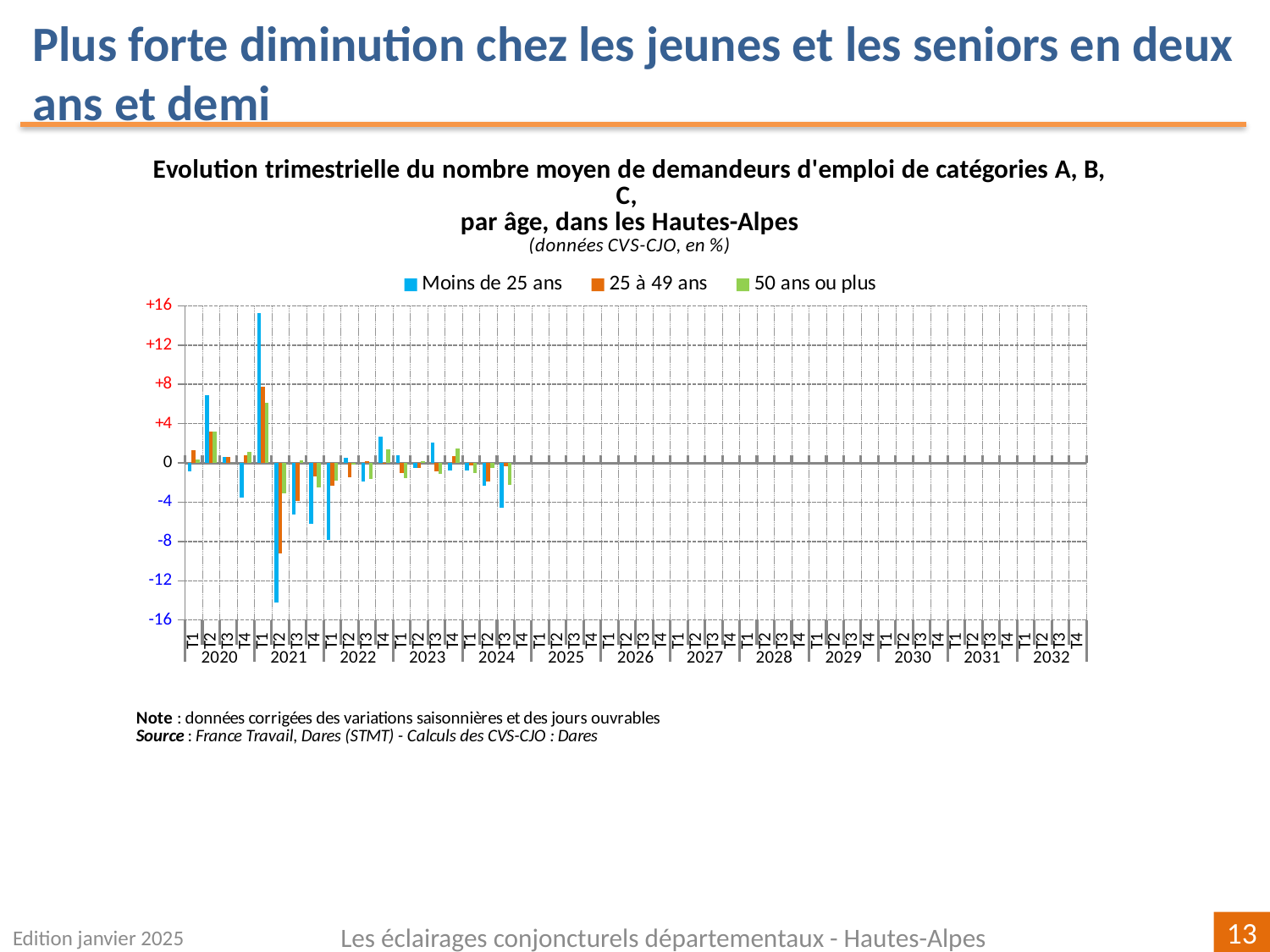
Which series is shown in blue in the legend? Moins de 25 ans In which quarter does the Moins de 25 ans series reach its highest value? T1 2021 How many series does the legend list? 3 Is the value for Moins de 25 ans in T2 2021 greater or less than -12? less Is the value for Moins de 25 ans in T2 2020 greater or less than +4? greater Is the value for 25 à 49 ans in T1 2021 greater or less than +4? greater In T1 2021, which series has the larger value: Moins de 25 ans or 25 à 49 ans? Moins de 25 ans What is the unit given in the chart subtitle for the data? en % In which quarter does the Moins de 25 ans series reach its lowest value? T2 2021 What kind of chart is shown on the slide? bar chart